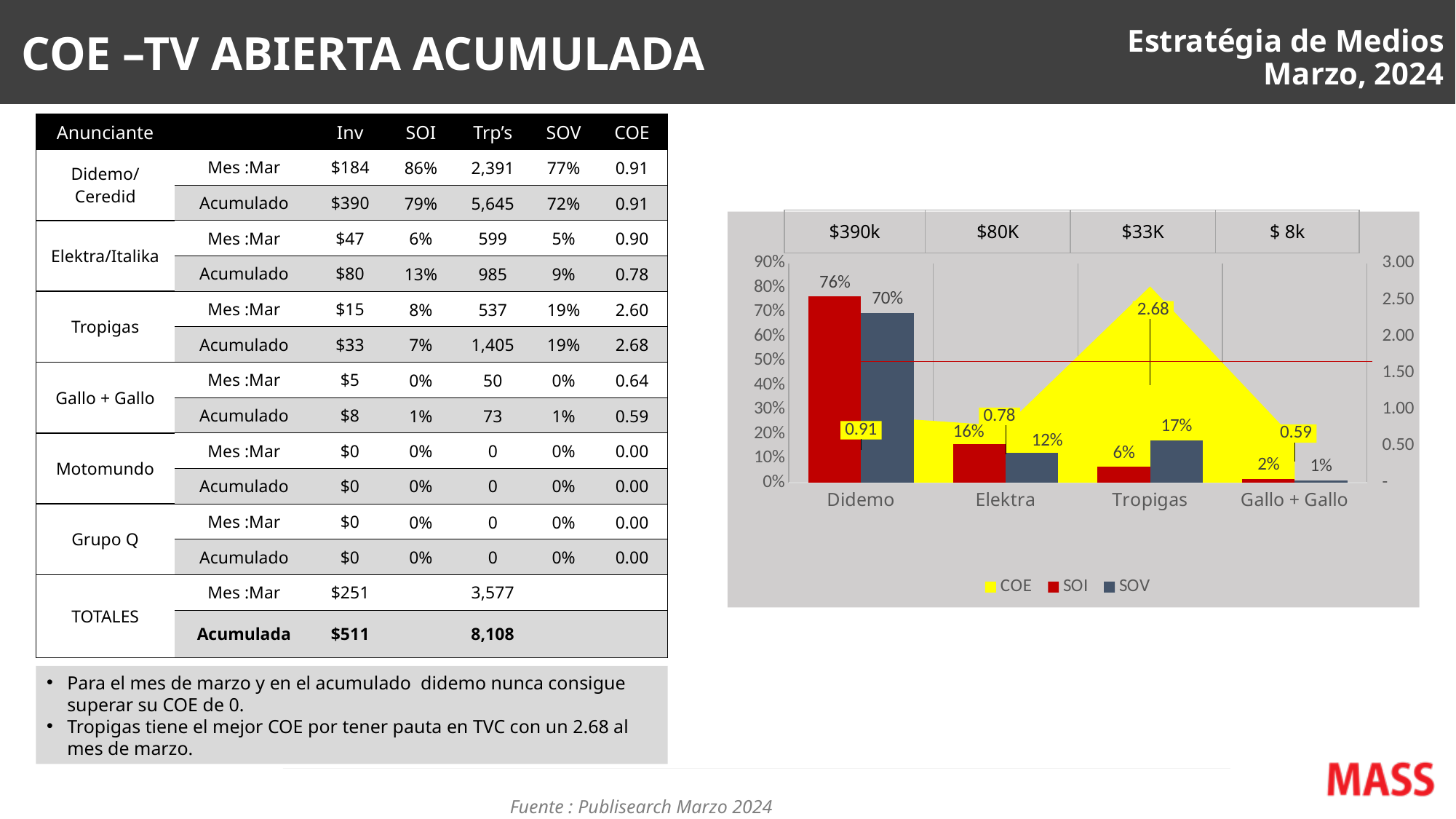
Which category has the lowest SOV value in the chart? Gallo + Gallo Do the SOI values rise or fall from Didemo to Gallo + Gallo along the x axis? fall What is the SOV value for Tropigas in the chart? 17% Is the SOI value for Didemo greater or less than 50%? greater Which category has the highest COE value in the chart? Tropigas How many categories are shown on the x axis of the chart? 4 Which series in the chart is shown in yellow? COE What is the COE value for Elektra in the chart? 0.78 What is the SOI value for Didemo in the chart? 76% What is the difference between the SOI and SOV values for Didemo in the chart? 6% How many series does the chart legend list? 3 Which is larger for Tropigas in the chart, SOI or SOV? SOV